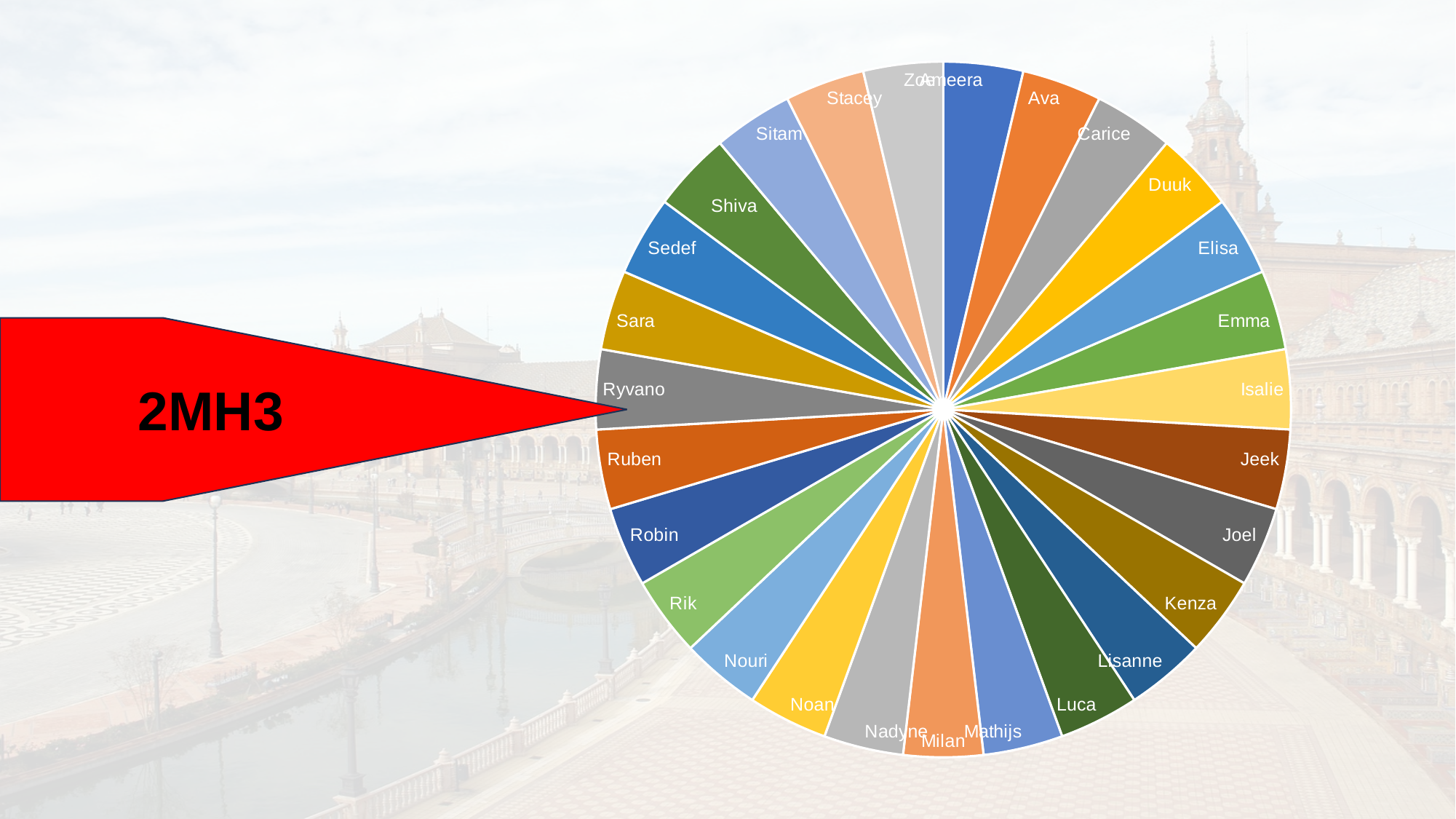
Which slice lies between Joel and Lisanne in the pie chart? Kenza Which slice of the pie chart does the red arrow labelled 2MH3 point to? Ryvano How many slices does the pie chart have? 27 Which slice label appears immediately clockwise after Ava in the pie chart? Carice Which slice lies between Robin and Ryvano in the pie chart? Ruben What colour is the slice labelled Duuk in the pie chart? yellow What kind of chart is shown on the slide? pie chart Which slice label appears immediately counter-clockwise before Ameera at the top of the pie chart? Zoe